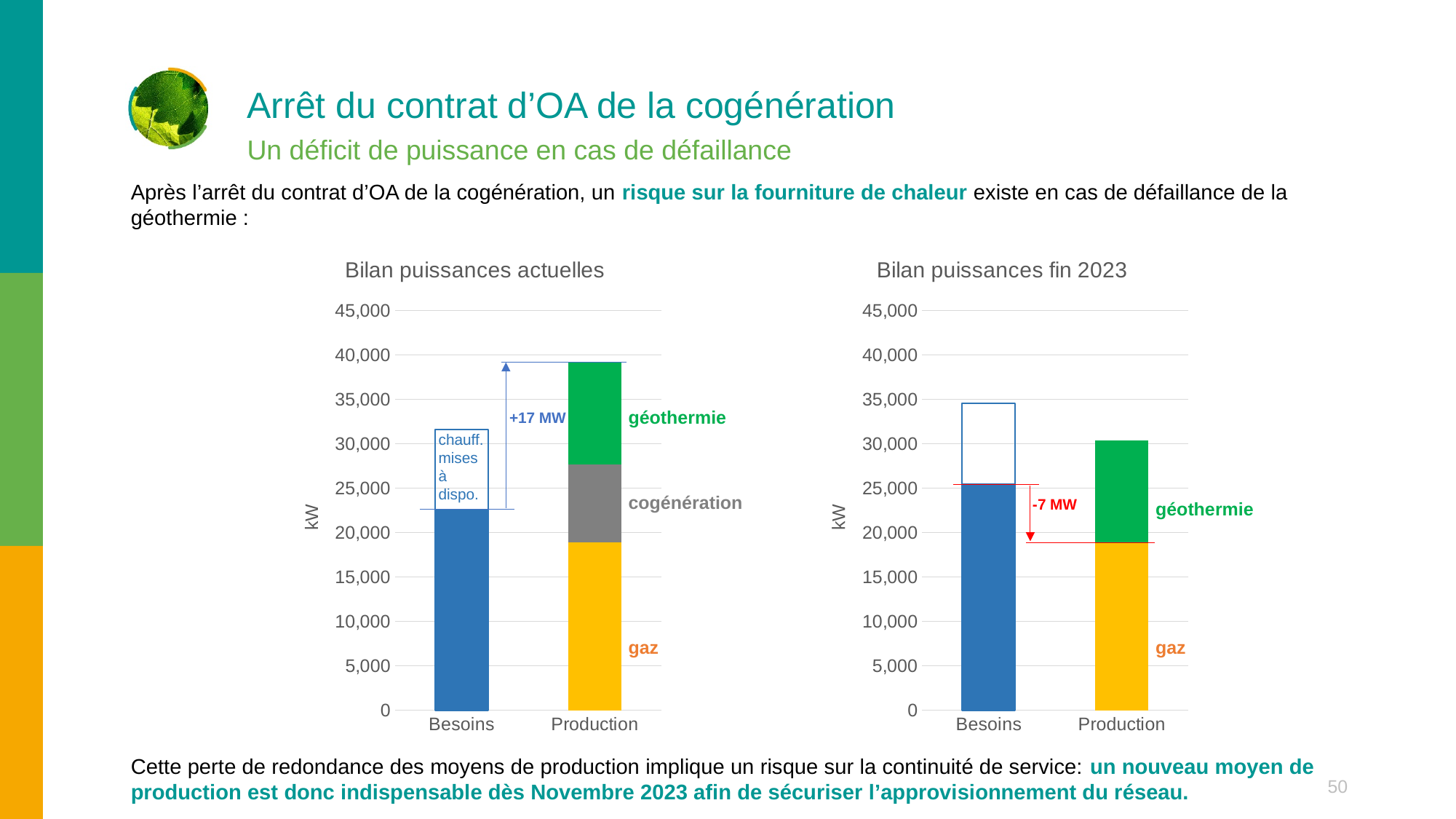
In the "Bilan puissances actuelles" chart, is the total Production bar greater or less than 40,000? less In the "Bilan puissances fin 2023" chart, is the gaz segment of the Production bar greater or less than 20,000? less In the "Bilan puissances fin 2023" chart, which is taller: the solid Besoins bar or the Production bar? Production In the "Bilan puissances actuelles" chart, what surplus is annotated between Besoins and Production? +17 MW How many categories are shown on the x axis of the "Bilan puissances fin 2023" chart? 2 In the "Bilan puissances fin 2023" chart, what deficit is annotated between Besoins and Production? -7 MW What unit is shown on the y axis of both charts? kW Which production source segment appears in the "Bilan puissances actuelles" chart but not in the "Bilan puissances fin 2023" chart? cogénération In the "Bilan puissances actuelles" chart, which is taller: the solid Besoins bar or the Production bar? Production In the "Bilan puissances actuelles" chart, is the solid Besoins bar greater or less than 20,000? greater What type of chart is "Bilan puissances actuelles"? bar chart